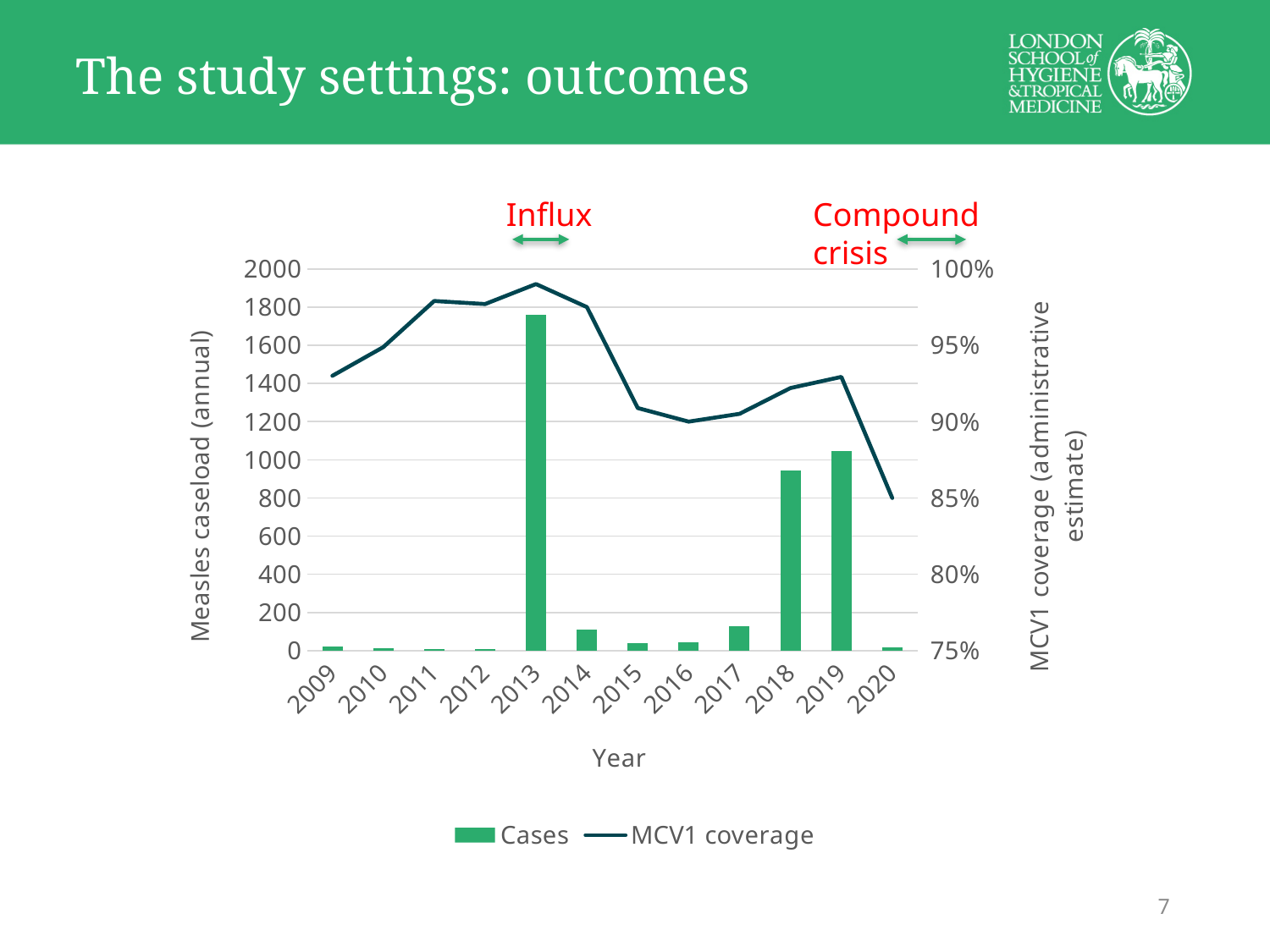
Is the measles caseload for 2018 greater or less than 1000? less Is the measles caseload for 2013 greater or less than 1600? greater Which year has the larger measles caseload, 2018 or 2019? 2019 What two events are annotated in red above the chart? Influx and Compound crisis Does MCV1 coverage rise or fall between 2013 and 2020? fall Is the MCV1 coverage for 2020 greater or less than 90%? less Which year has the highest measles caseload? 2013 How many series does the chart's legend list? 2 What is the title of the left vertical axis? Measles caseload (annual) What kind of chart is shown on the slide? A combined bar and line chart How many years are shown on the x axis of the chart? 12